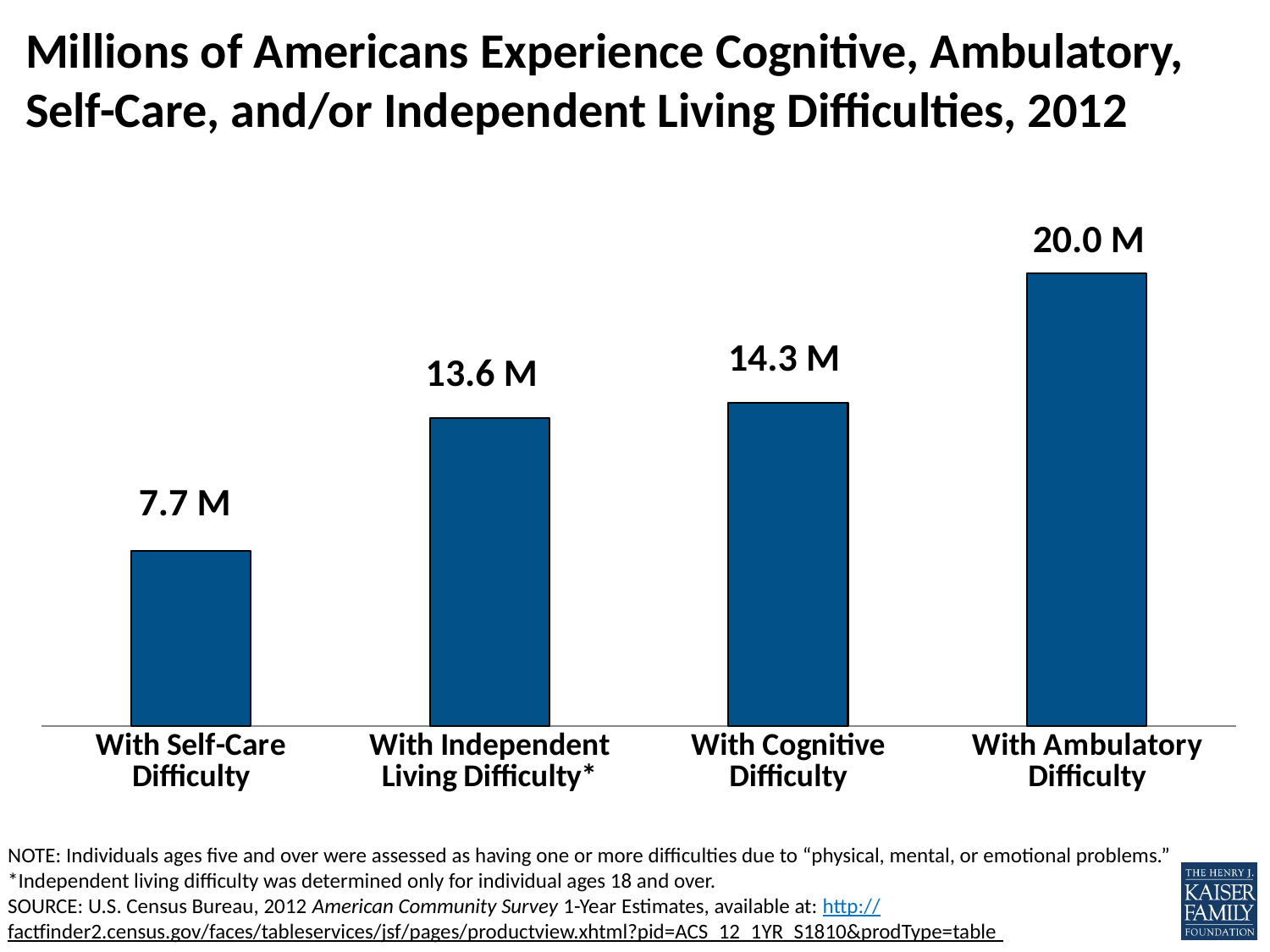
How many categories are shown in the chart? 4 What is the difference between the values for With Ambulatory Difficulty and With Self-Care Difficulty? 12.3 M What is the value for With Independent Living Difficulty*? 13.6 M Do the values rise or fall from left to right across the categories? Rise Which category has the lowest value? With Self-Care Difficulty What is the value for With Ambulatory Difficulty? 20.0 M What is the difference between the values for With Cognitive Difficulty and With Independent Living Difficulty*? 0.7 M Which category has the highest value? With Ambulatory Difficulty Which is larger, the value for With Ambulatory Difficulty or the value for With Cognitive Difficulty? With Ambulatory Difficulty What is the value for With Self-Care Difficulty? 7.7 M What is the value for With Cognitive Difficulty? 14.3 M What kind of chart is shown on the slide? Bar chart